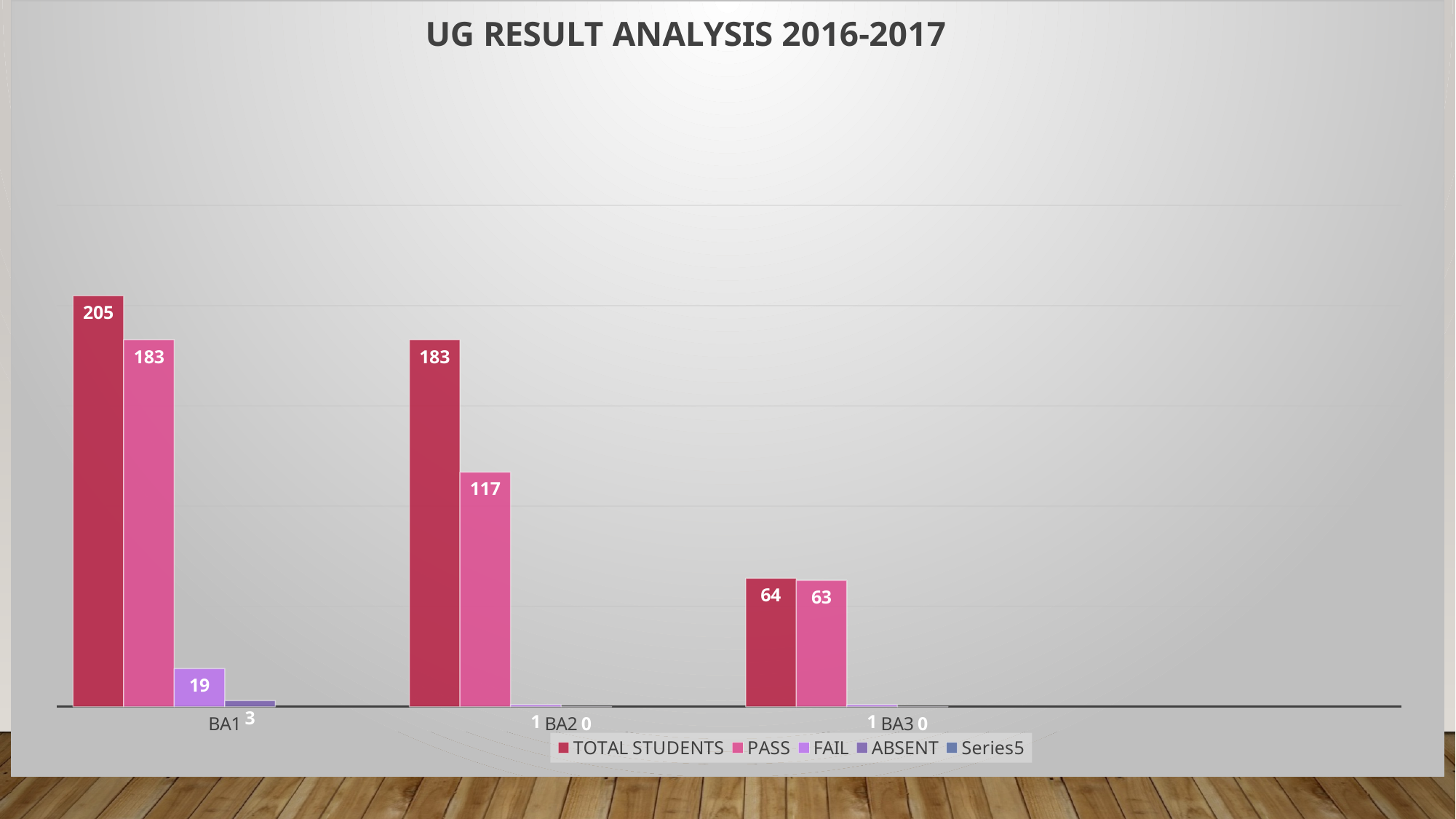
What is the TOTAL STUDENTS value for BA1? 205 What kind of chart is shown on the slide? Bar chart What is the PASS value for BA3? 63 What is the FAIL value for BA1? 19 What is the PASS value for BA2? 117 What is the title of the chart? UG RESULT ANALYSIS 2016-2017 Which is larger, the PASS value for BA1 or the PASS value for BA2? BA1 Which category has the lowest PASS value? BA3 Which category has the highest TOTAL STUDENTS value? BA1 How many categories are shown on the x axis? 3 What is the difference between TOTAL STUDENTS and PASS for BA2? 66 How many series does the legend list? 5